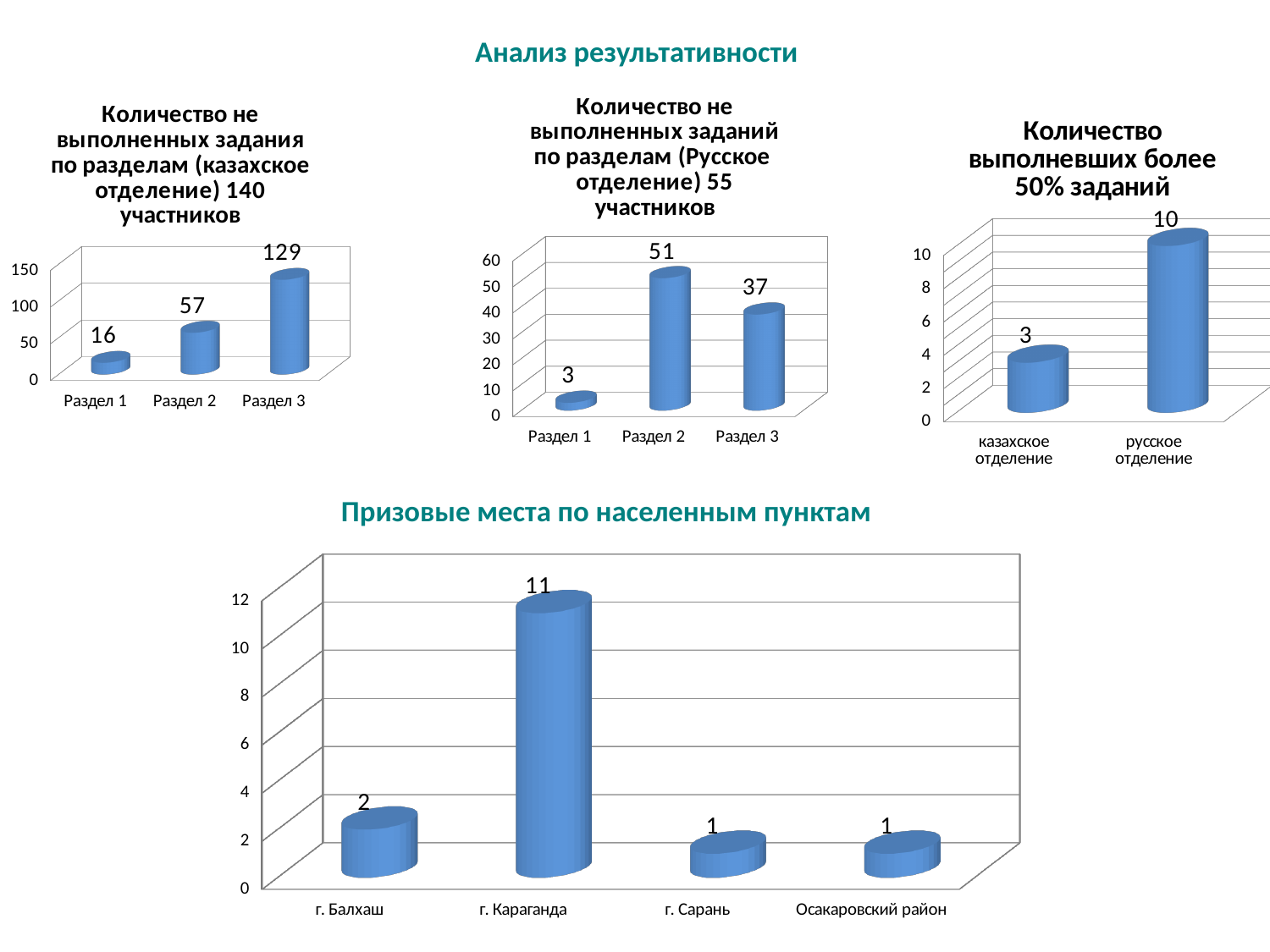
In the top-middle chart (Русское отделение), which section has the highest value? Раздел 2 In the top-right chart (Количество выполневших более 50% заданий), what is the difference between русское отделение and казахское отделение? 7 In the top-left chart (казахское отделение), what is the difference between Раздел 3 and Раздел 2? 72 In the top-middle chart (Русское отделение), which is larger: Раздел 2 or Раздел 3? Раздел 2 What kind of chart is the bottom chart (Призовые места по населенным пунктам)? Bar chart In the bottom chart (Призовые места по населенным пунктам), which category has the highest value? г. Караганда In the bottom chart (Призовые места по населенным пунктам), what is the value for г. Караганда? 11 In the top-left chart (казахское отделение), which section has the lowest value? Раздел 1 In the bottom chart (Призовые места по населенным пунктам), how many categories are shown on the x axis? 4 In the top-left chart (казахское отделение), what is the value for Раздел 3? 129 In the top-right chart (Количество выполневших более 50% заданий), what is the value for русское отделение? 10 In the top-middle chart (Русское отделение), what is the value for Раздел 2? 51